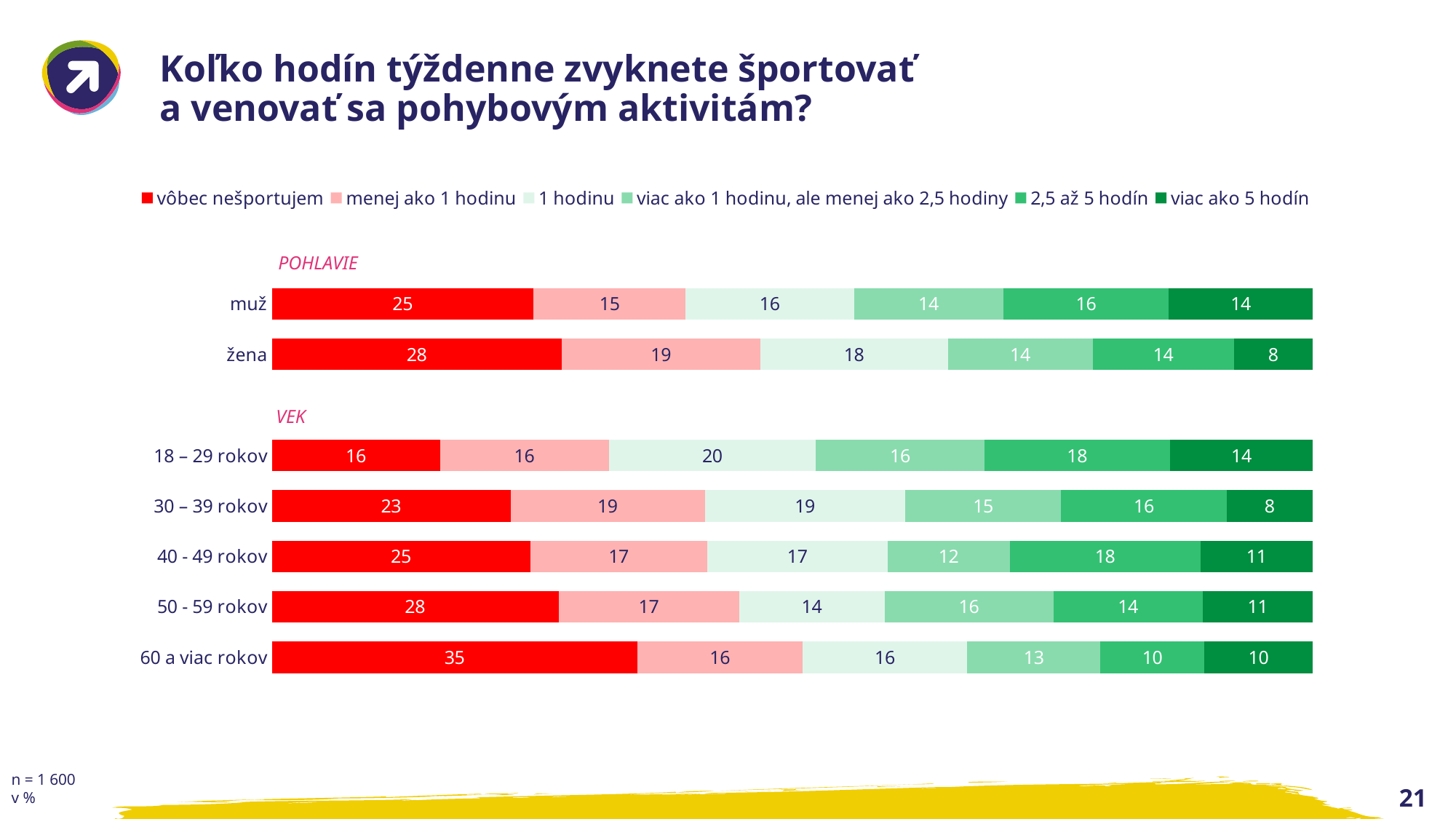
Which category has the lowest value for "vôbec nešportujem"? 18 – 29 rokov What is the total of the segments in the "60 a viac rokov" bar? 100 What is the value for "vôbec nešportujem" in the "muž" bar? 25 Which category has the highest value for "vôbec nešportujem"? 60 a viac rokov What kind of chart is shown on the slide? stacked bar chart What is the value for "2,5 až 5 hodín" in the "40 - 49 rokov" bar? 18 What is the difference between the "vôbec nešportujem" values for "žena" and "muž"? 3 What is the value for "1 hodinu" in the "18 – 29 rokov" bar? 20 How many series does the legend list? 6 How many category bars are shown in the chart? 7 Which has the larger value for "viac ako 5 hodín", "muž" or "žena"? muž What is the value for "viac ako 5 hodín" in the "žena" bar? 8